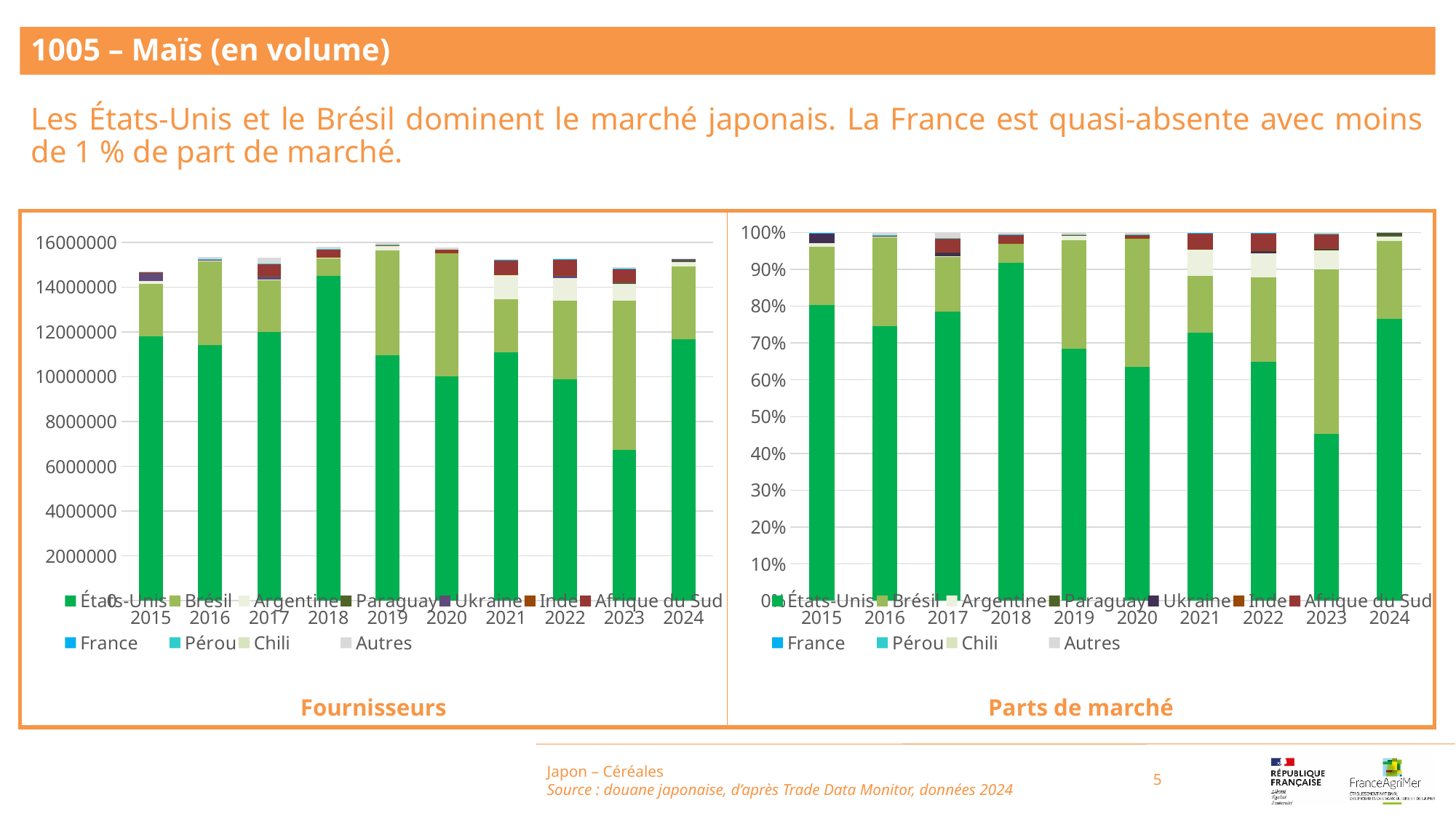
In the 'Fournisseurs' chart, is the value for États-Unis in 2023 greater or less than 8000000? less In the 'Fournisseurs' chart, in which year is the volume for États-Unis the lowest? 2023 How many series does the legend of the 'Fournisseurs' chart list? 11 In the 'Parts de marché' chart, in which year is the share of États-Unis the highest? 2018 How many years are shown on the x axis of the 'Parts de marché' chart? 10 In the 'Parts de marché' chart, is the share for États-Unis in 2018 greater or less than 90%? greater In the 'Parts de marché' chart, is the share of Brésil larger in 2015 or in 2023? 2023 In the 'Parts de marché' chart, is the share for États-Unis in 2023 greater or less than 50%? less What kind of chart is the 'Fournisseurs' chart on the left? Stacked bar chart In the 'Fournisseurs' chart, is the volume for États-Unis larger in 2015 or in 2020? 2015 In the 'Parts de marché' chart, in which year is the share of États-Unis the lowest? 2023